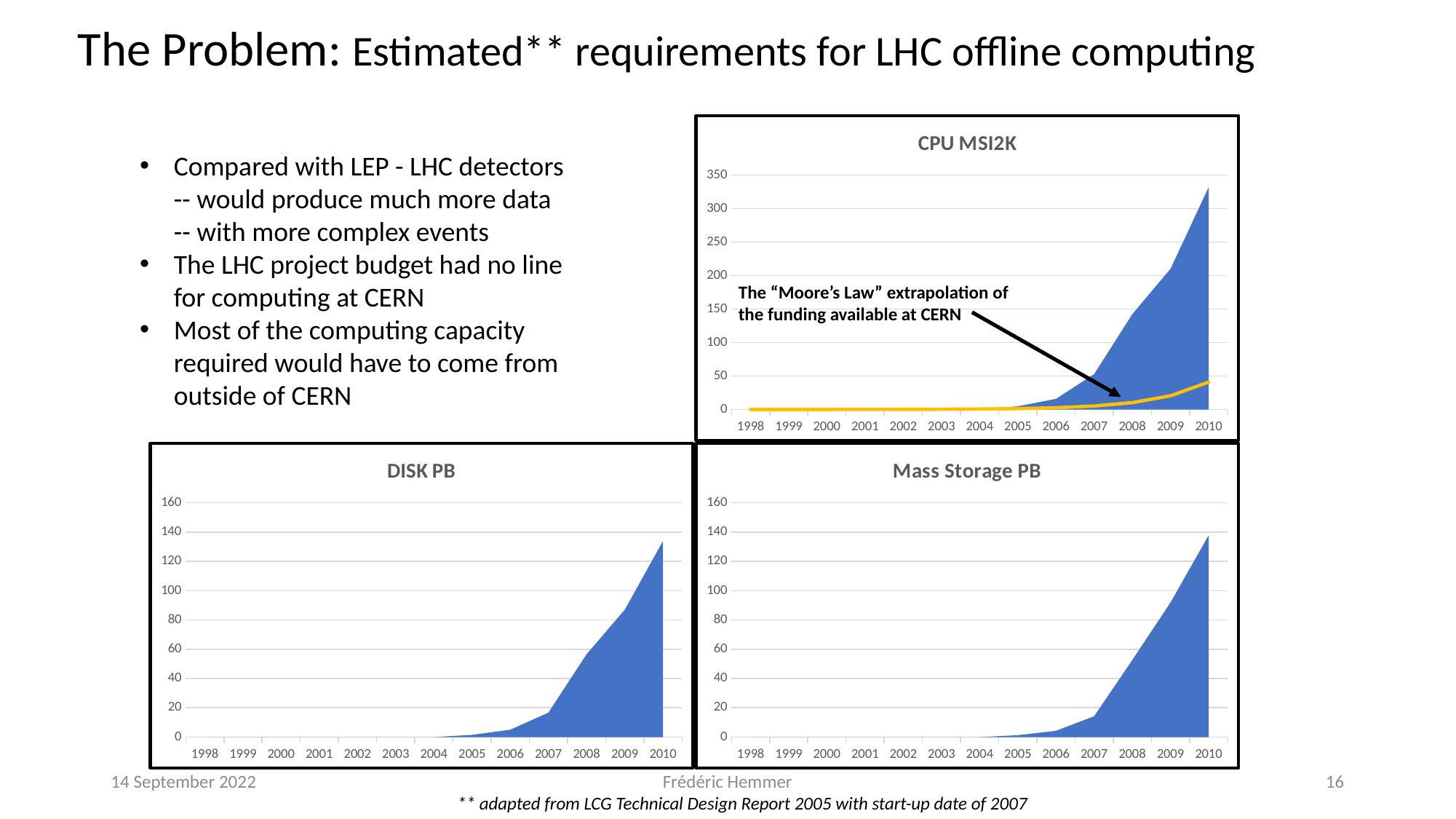
How many years are shown on the x axis of the DISK PB chart? 13 In the CPU MSI2K chart, is the yellow line's value for 2010 greater or less than 50? less What kind of chart is the CPU MSI2K chart? combination area and line chart In the DISK PB chart, do the values rise or fall from 1998 to 2010? rise In the Mass Storage PB chart, is the value for 2007 greater or less than 20? less In the CPU MSI2K chart, is the blue area's value for 2006 greater or less than 50? less What is the title of the chart at the top right of the slide? CPU MSI2K In the CPU MSI2K chart, which year has the highest blue area value? 2010